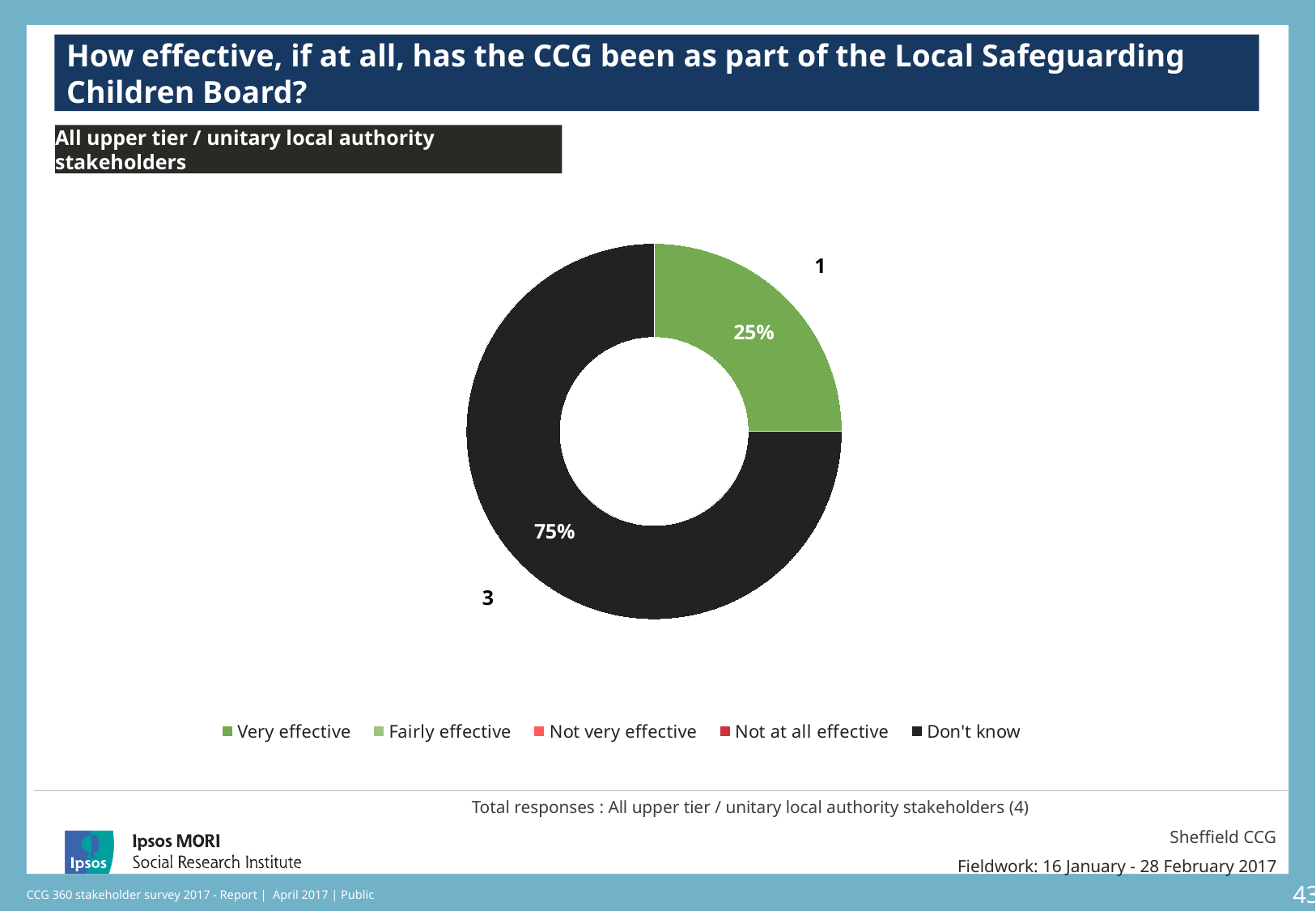
What kind of chart is shown on the slide? Pie chart (donut) How many responses does the Don't know slice represent? 3 What is the total number of responses stated below the chart? 4 What percentage of responses is shown for the Don't know slice? 75% Which is larger, the Don't know slice or the green slice? Don't know What colour is the Don't know slice? Black Which slice of the chart is the largest? Don't know What percentage of responses is shown for the green slice? 25% How many slices with data labels are visible in the chart? 2 How many entries does the legend list? 5 What is the difference in percentage points between the Don't know slice and the green slice? 50 percentage points How many responses does the green slice represent? 1